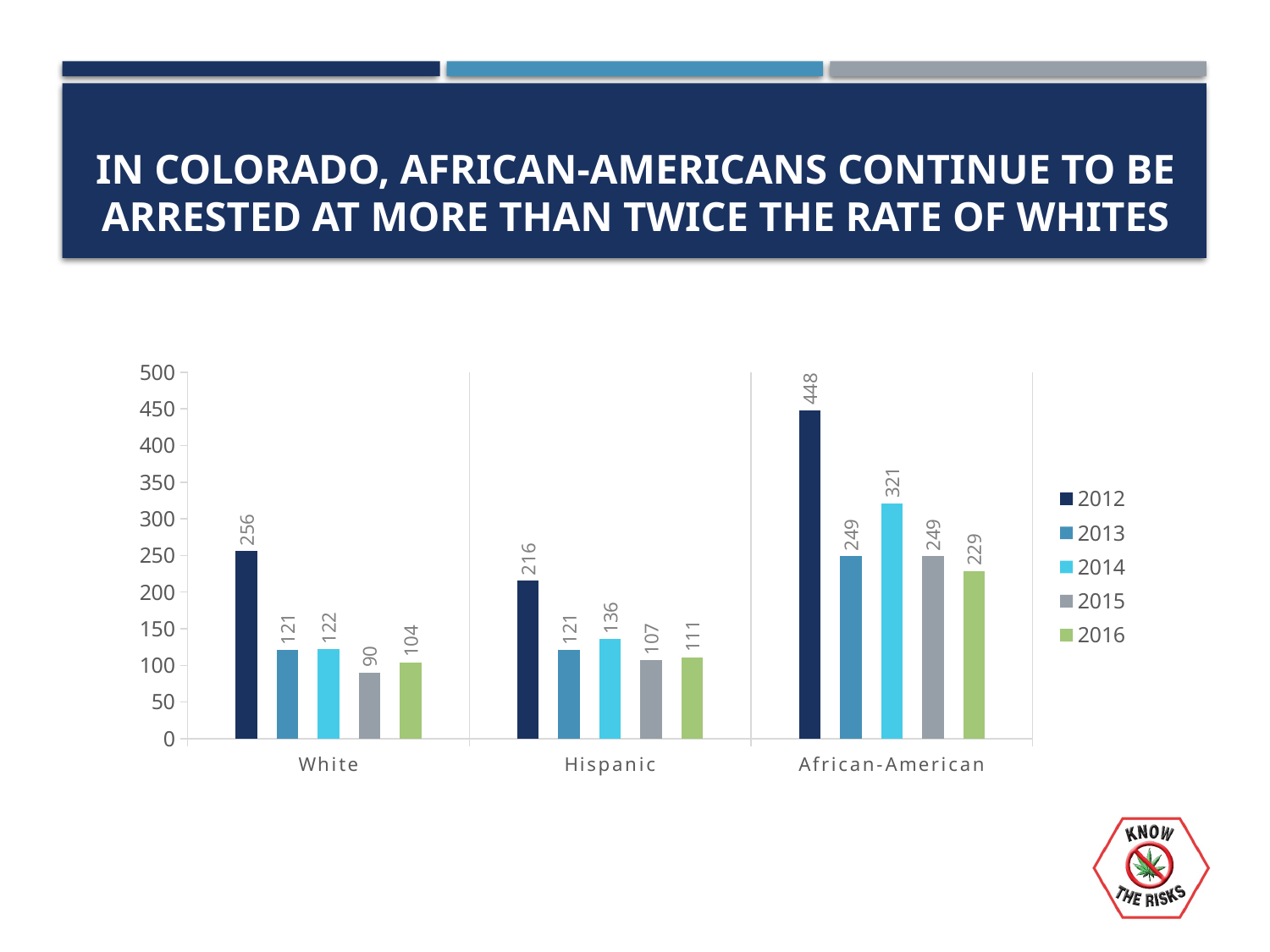
How many series does the legend list? 5 What is the difference between the 2012 values for African-American and White? 192 What is the value for Hispanic in 2016? 111 Which year is shown in light green in the legend? 2016 What is the value for White in 2012? 256 What kind of chart is shown on the slide? bar chart What is the value for African-American in 2014? 321 Which year has the highest value for African-American? 2012 Is the 2016 value for African-American greater or less than 200? greater Which year has the lowest value for White? 2015 Which is larger, the 2014 value for Hispanic or the 2014 value for White? Hispanic How many categories are shown on the x axis? 3